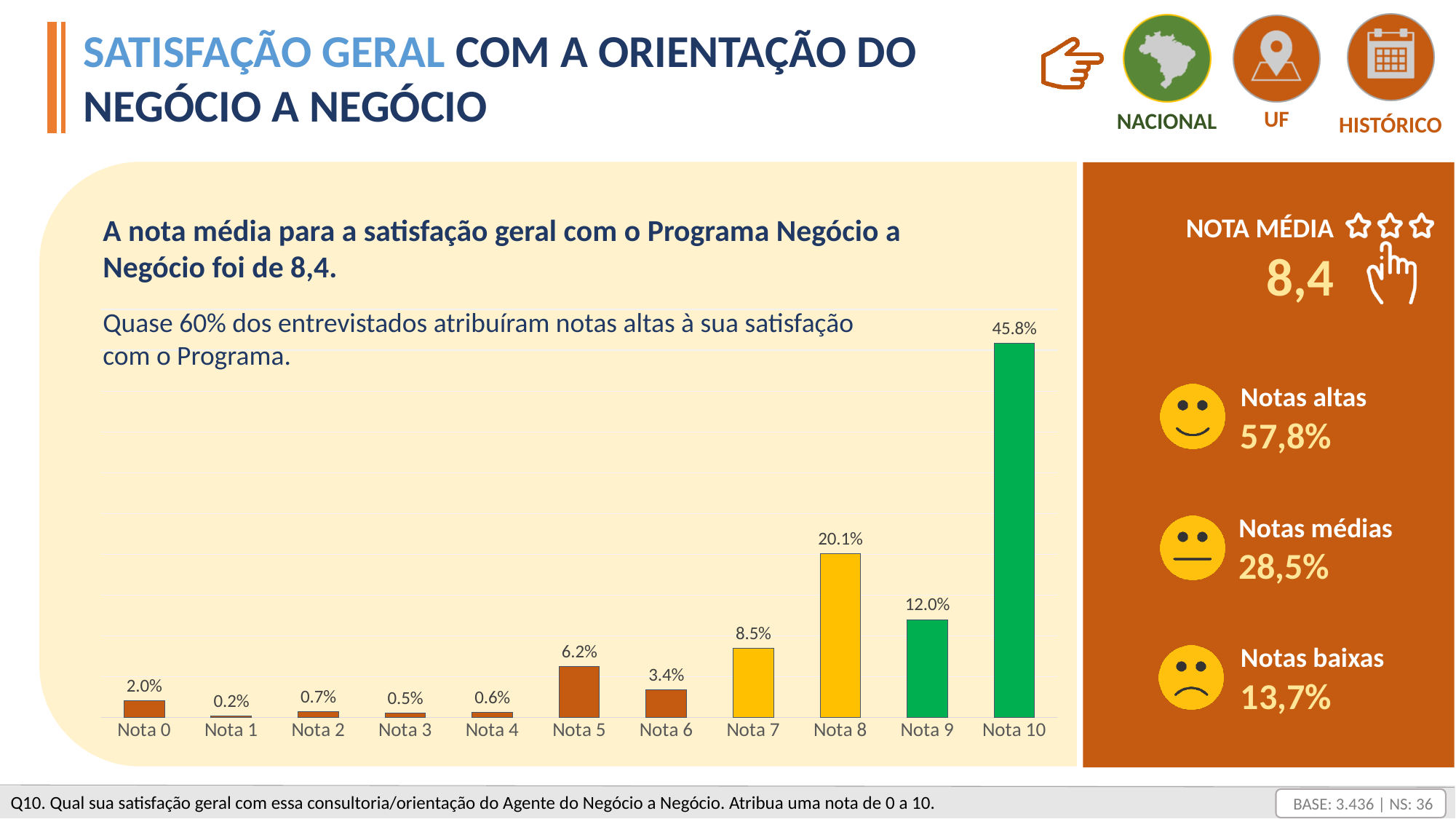
How many categories are shown on the x axis? 11 Which is larger, the value for Nota 5 or the value for Nota 6? Nota 5 Which category has the highest value? Nota 10 What is the value for Nota 8? 20.1% What is the value for Nota 10? 45.8% What is the total of the values for Nota 9 and Nota 10? 57.8% What colour are the bars for Nota 9 and Nota 10? Green What is the difference between the values for Nota 10 and Nota 8? 25.7% Which category has the lowest value? Nota 1 What is the value for Nota 1? 0.2% What kind of chart is shown? Bar chart What is the value for Nota 7? 8.5%